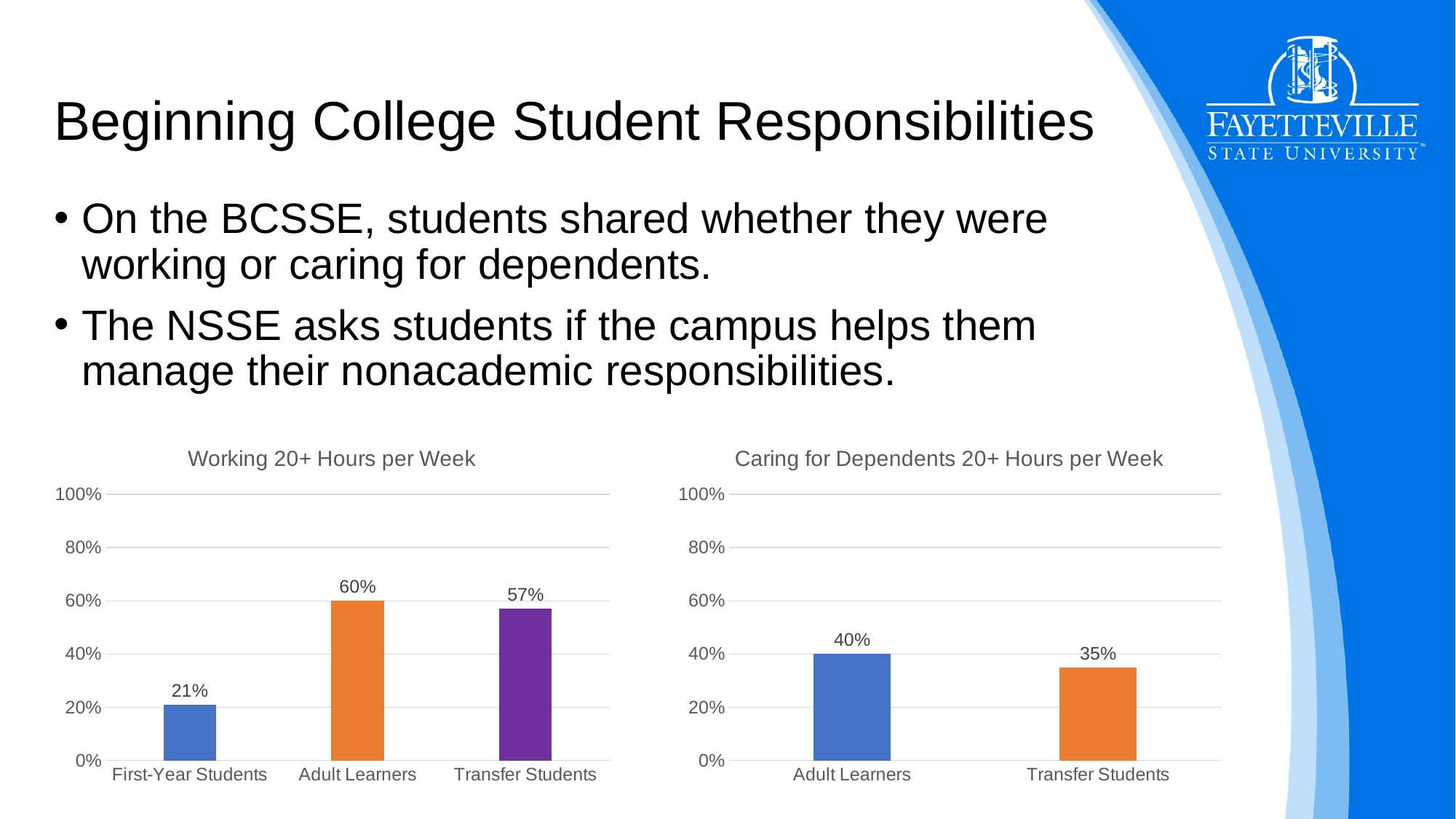
In the 'Caring for Dependents 20+ Hours per Week' chart, what is the difference between Adult Learners and Transfer Students? 5% In the 'Working 20+ Hours per Week' chart, what is the value for First-Year Students? 21% In the 'Working 20+ Hours per Week' chart, which category has the highest value? Adult Learners In the 'Caring for Dependents 20+ Hours per Week' chart, what is the value for Adult Learners? 40% In the 'Caring for Dependents 20+ Hours per Week' chart, which is larger, Adult Learners or Transfer Students? Adult Learners What kind of chart is the 'Caring for Dependents 20+ Hours per Week' chart? Bar chart In the 'Working 20+ Hours per Week' chart, what is the difference between Adult Learners and Transfer Students? 3% In the 'Working 20+ Hours per Week' chart, what is the value for Adult Learners? 60% In the 'Working 20+ Hours per Week' chart, which category has the lowest value? First-Year Students In the 'Working 20+ Hours per Week' chart, what colour is the Transfer Students bar? Purple In the 'Caring for Dependents 20+ Hours per Week' chart, what is the value for Transfer Students? 35% In the 'Working 20+ Hours per Week' chart, how many categories are shown? 3